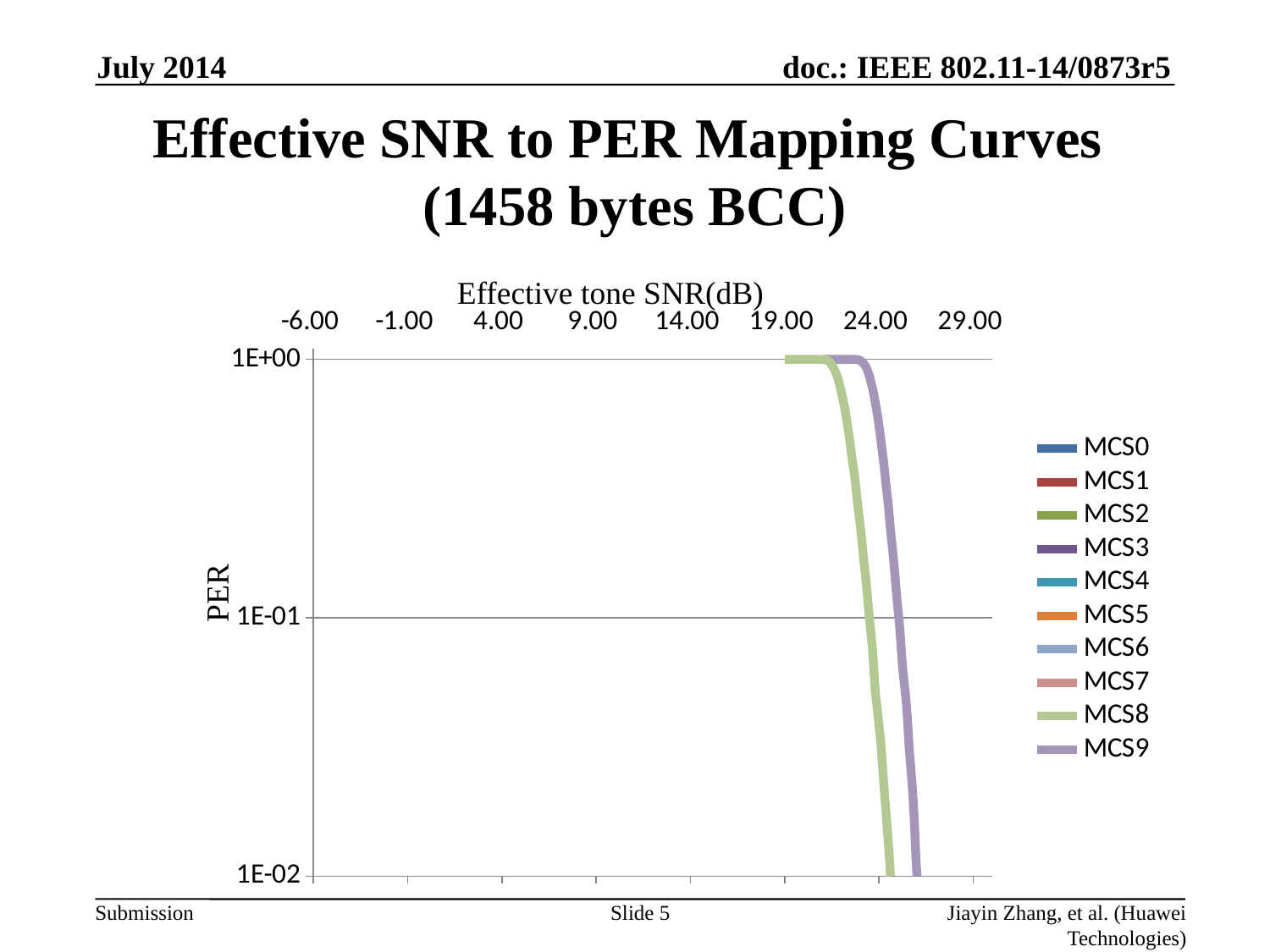
What is the label on the vertical axis? PER How many series does the legend list? 10 Which of the two visible curves lies further to the right (requires higher SNR for the same PER), MCS8 or MCS9? MCS9 As the effective tone SNR increases, does the PER of the MCS8 curve rise or fall? fall What kind of chart is shown on the slide? line chart What is the highest tick value shown on the horizontal axis? 29.00 Is the PER of the MCS9 curve at an effective tone SNR of 19.00 dB greater or less than 1E-01? greater Which curve reaches a PER of 1E-01 at a lower effective tone SNR, MCS8 or MCS9? MCS8 What is the title of the chart's horizontal axis? Effective tone SNR(dB)